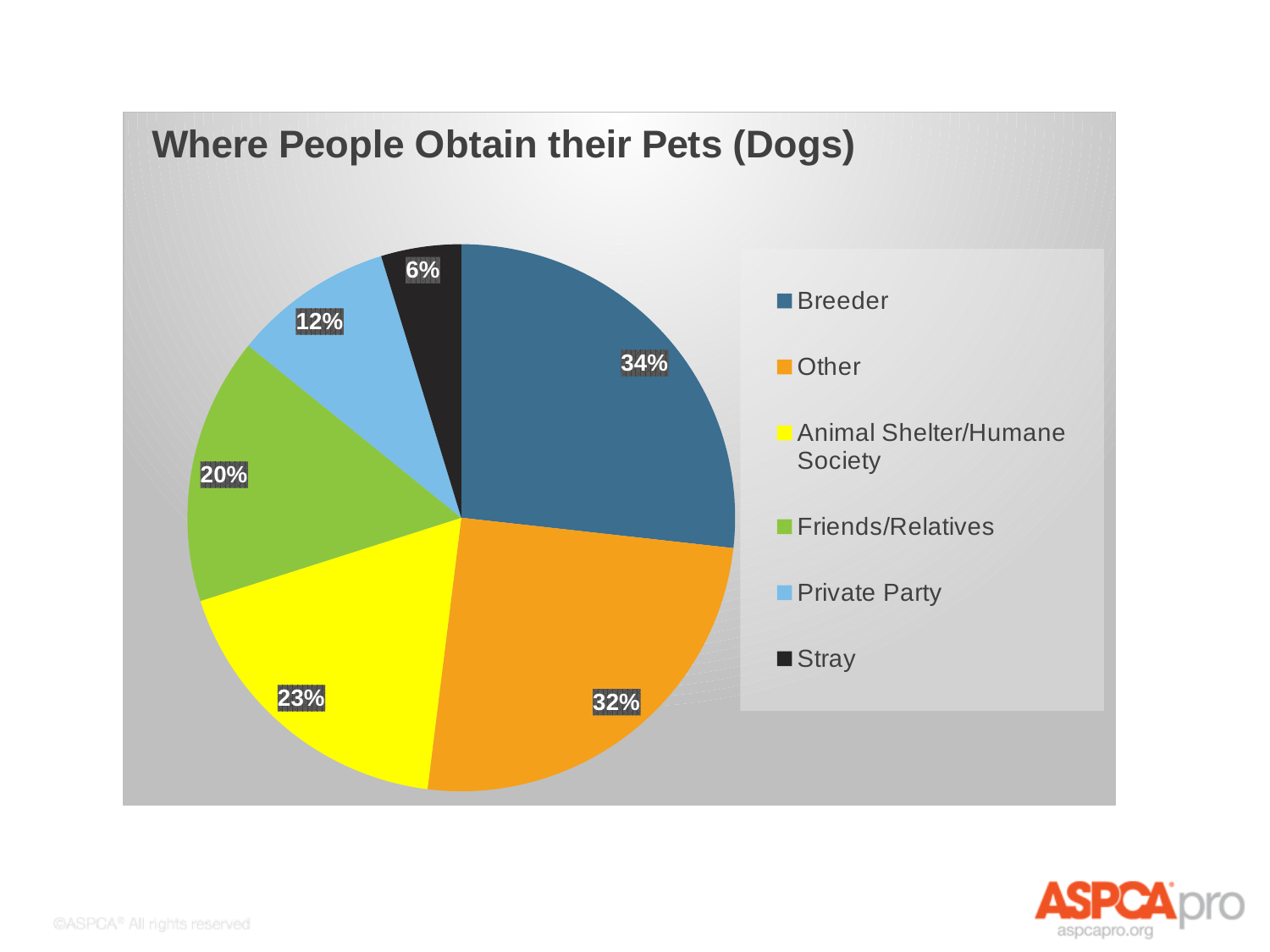
What percentage is shown for Friends/Relatives? 20% Which source has the largest share of the pie? Breeder What percentage of people obtain their dogs from a breeder? 34% Which is larger, the share for Animal Shelter/Humane Society or the share for Private Party? Animal Shelter/Humane Society What is the difference between the Friends/Relatives share and the Private Party share? 8% What is the difference between the Breeder share and the Other share? 2% Which source has the smallest share of the pie? Stray What share of the pie is Animal Shelter/Humane Society? 23% What is the title of the chart? Where People Obtain their Pets (Dogs) How many categories does the legend list? 6 What percentage is shown for Stray? 6% What kind of chart is shown on the slide? pie chart